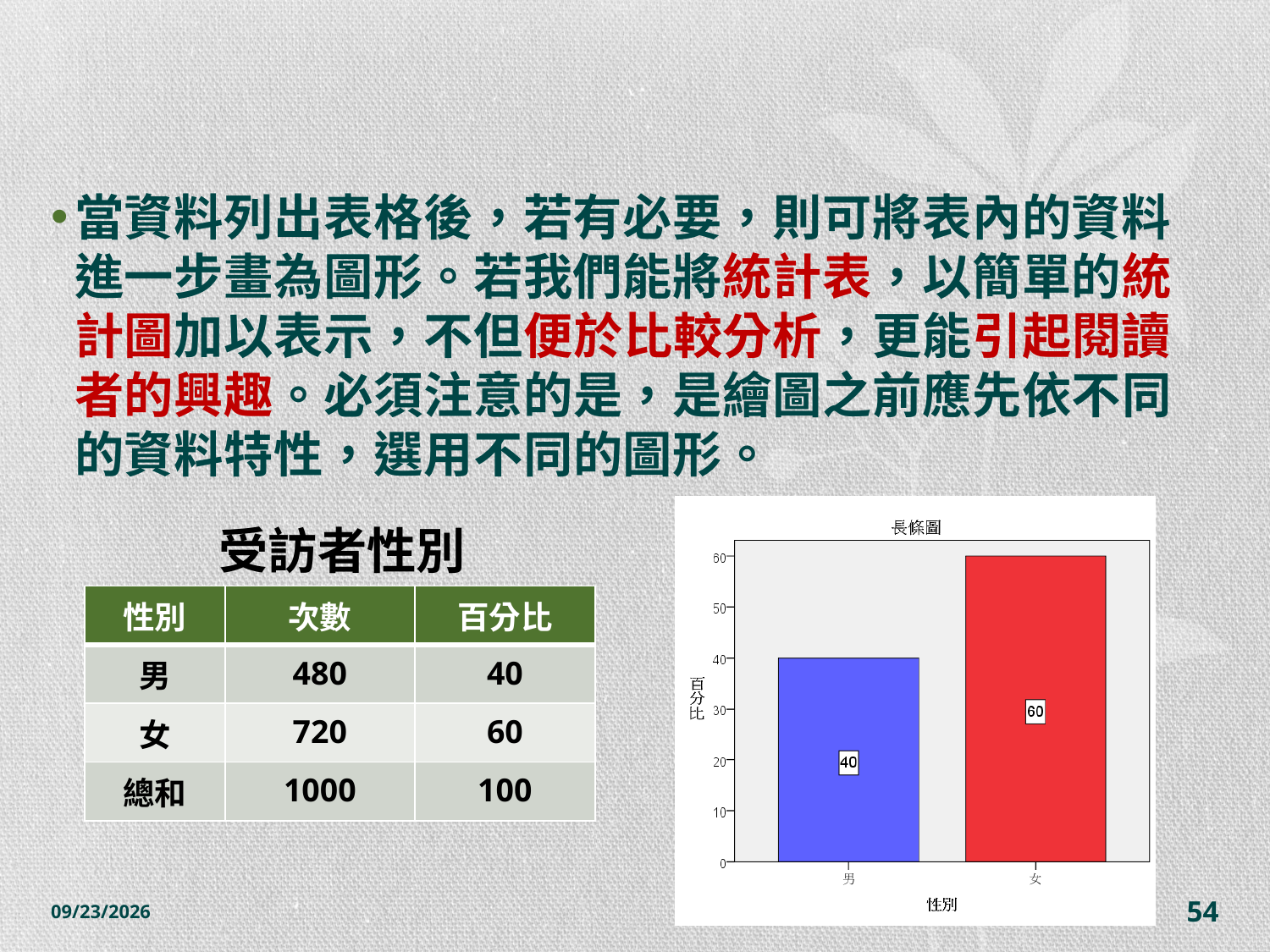
What is the value for 男 in the chart? 40 What is the value for 女 in the chart? 60 Is the value for 女 greater or less than 50? greater Is the value for 男 greater or less than 50? less What is the difference between the values for 女 and 男 in the chart? 20 What is the title of the chart? 長條圖 What is the label of the y axis of the chart? 百分比 Which is larger in the chart, the value for 男 or the value for 女? 女 How many categories are shown on the x axis of the chart? 2 Which category has the lowest value in the chart? 男 Which category has the highest value in the chart? 女 What type of chart is shown on the slide? bar chart